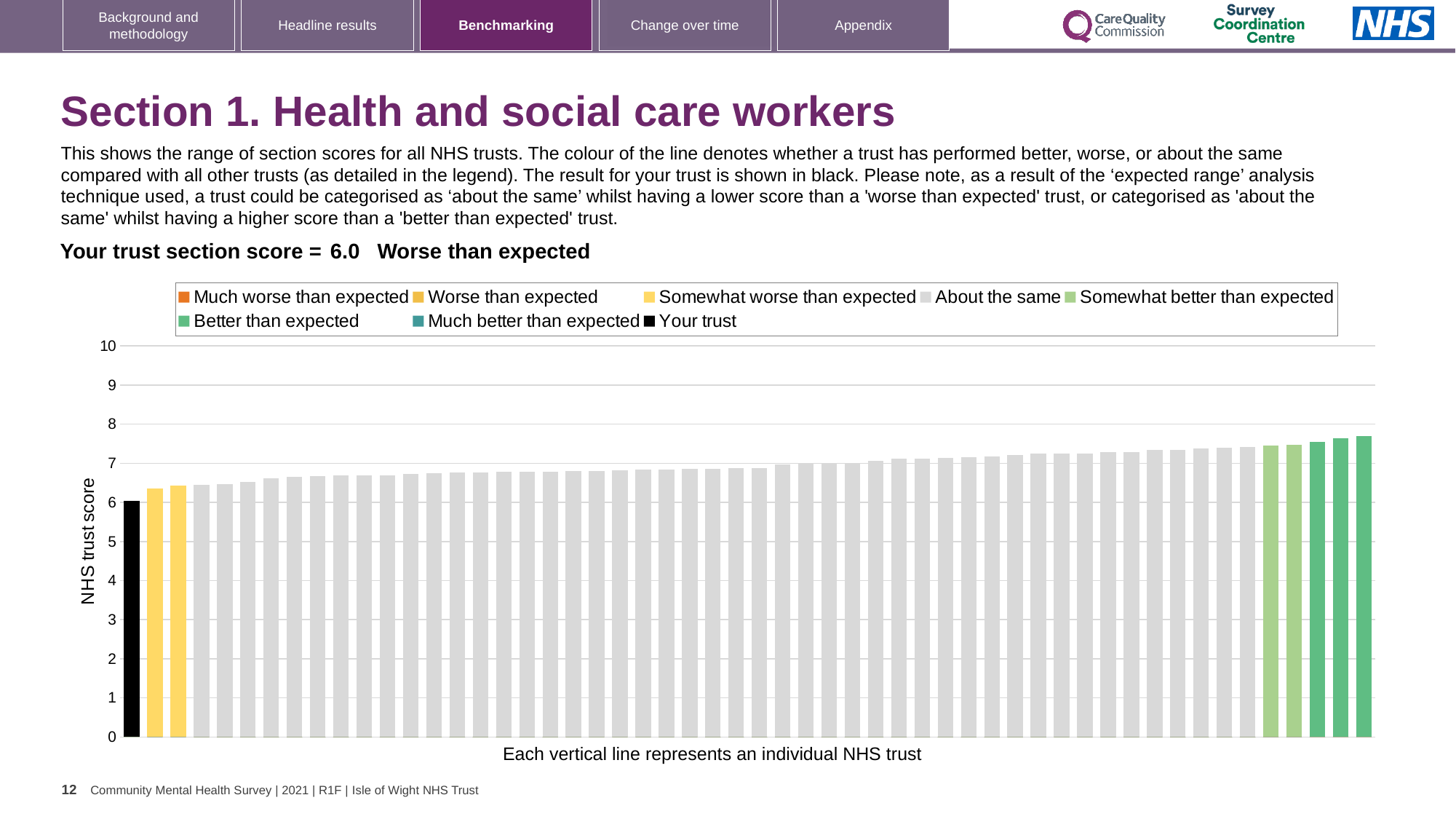
Do the bar values rise or fall from left to right along the x axis? rise Is the black 'Your trust' bar larger or smaller than the yellow 'Worse than expected' bars next to it? smaller What is the section score for your trust, as printed on the slide? 6.0 What kind of chart is shown on the slide? bar chart Which bar in the chart is the lowest? Your trust (the black bar) Is the value of the highest bar (the rightmost bar) greater or less than 8? less Is the value of the black 'Your trust' bar greater or less than 7? less Is the value of the black 'Your trust' bar greater or less than 5? greater According to the slide, which performance category does your trust's section score fall into? Worse than expected What is the label on the vertical axis of the chart? NHS trust score How many entries does the chart legend list? 8